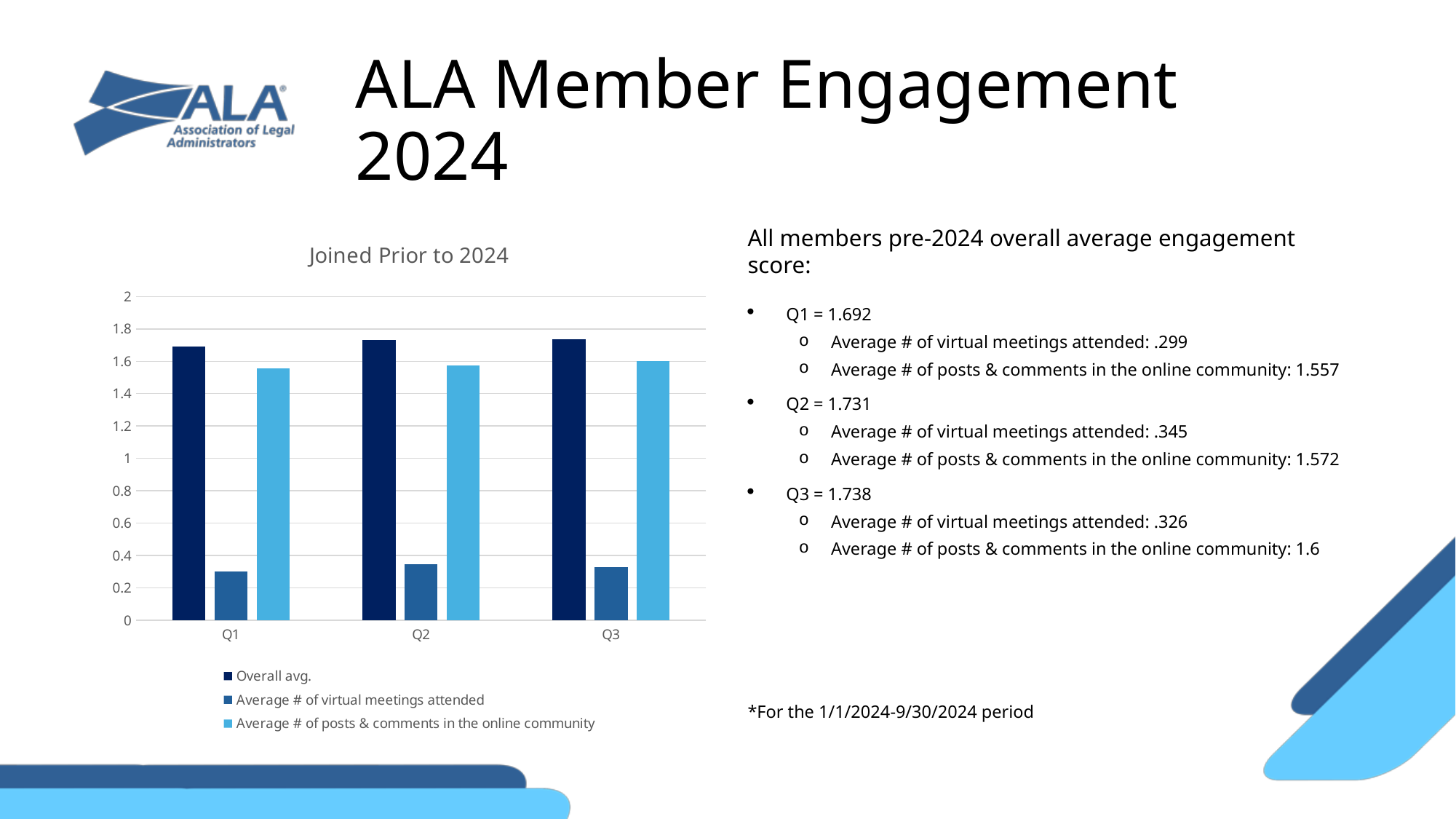
What is the overall average engagement score for Q2? 1.731 What is the title of the chart? Joined Prior to 2024 Is the value for average # of virtual meetings attended in Q2 greater or less than 0.4? less What is the average number of virtual meetings attended in Q1? .299 How many series does the chart legend list? 3 Which quarter has the lowest average number of virtual meetings attended? Q1 Which quarter has the highest overall average engagement score? Q3 What is the average number of posts & comments in the online community in Q3? 1.6 Does the overall average engagement score rise or fall from Q1 to Q3? rise Is the overall avg. value for Q1 greater or less than 1.6? greater What kind of chart is shown on the slide? bar chart How many quarters are shown on the x axis of the chart? 3